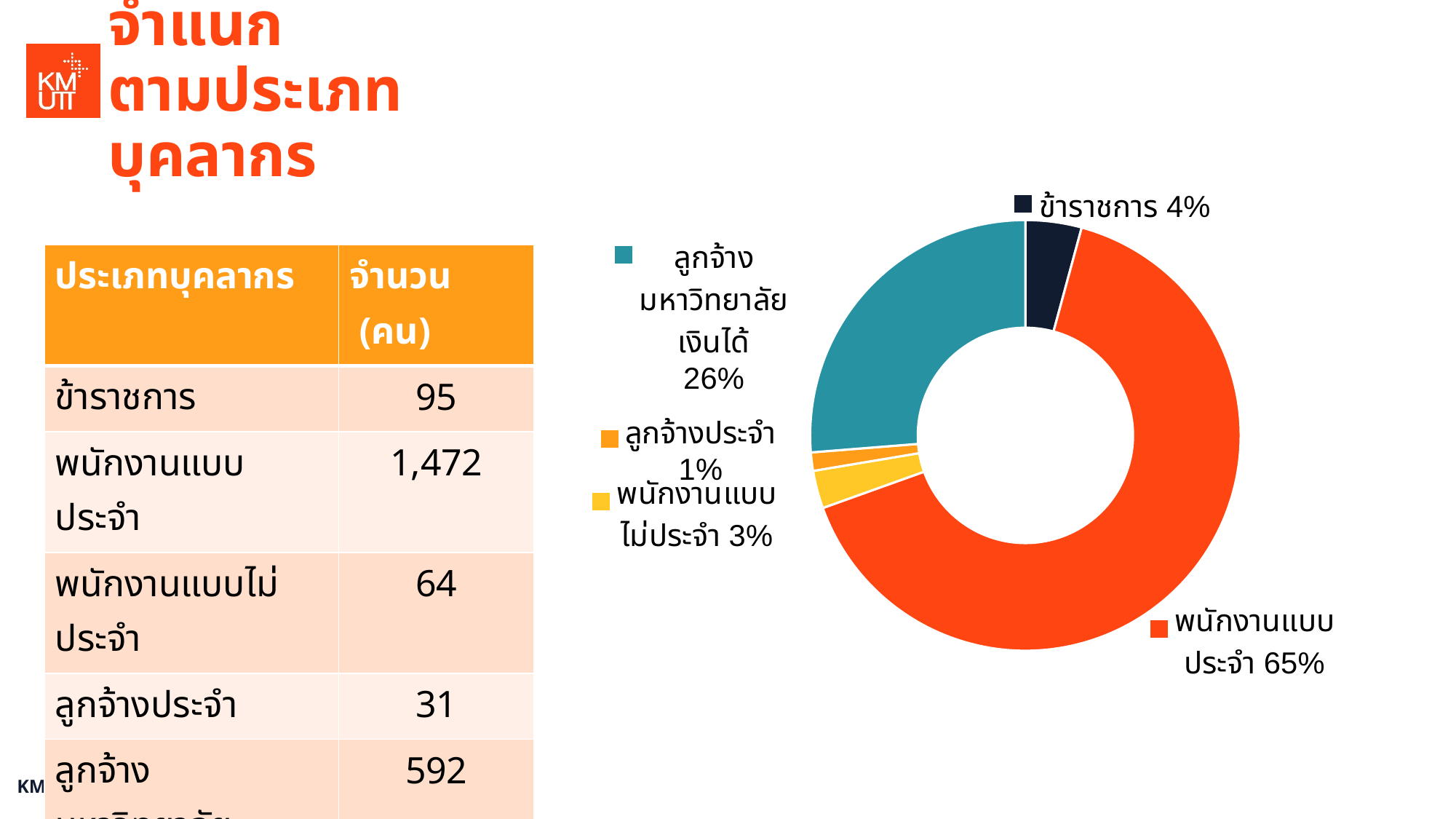
What percentage is shown for ข้าราชการ in the doughnut chart? 4% How many categories are shown in the doughnut chart? 5 What percentage is shown for พนักงานแบบไม่ประจำ in the doughnut chart? 3% Which is larger in the doughnut chart, ข้าราชการ or พนักงานแบบไม่ประจำ? ข้าราชการ What kind of chart is shown on the slide? Doughnut (pie) chart What colour is the slice for ลูกจ้างมหาวิทยาลัยเงินได้ in the doughnut chart? Teal What share of the doughnut chart does ลูกจ้างมหาวิทยาลัยเงินได้ represent? 26% Which category has the largest slice in the doughnut chart? พนักงานแบบประจำ Which category has the smallest slice in the doughnut chart? ลูกจ้างประจำ What is the difference in percentage points between พนักงานแบบประจำ and ลูกจ้างมหาวิทยาลัยเงินได้ in the doughnut chart? 39 percentage points What share of the doughnut chart does พนักงานแบบประจำ represent? 65% What percentage is shown for ลูกจ้างประจำ in the doughnut chart? 1%